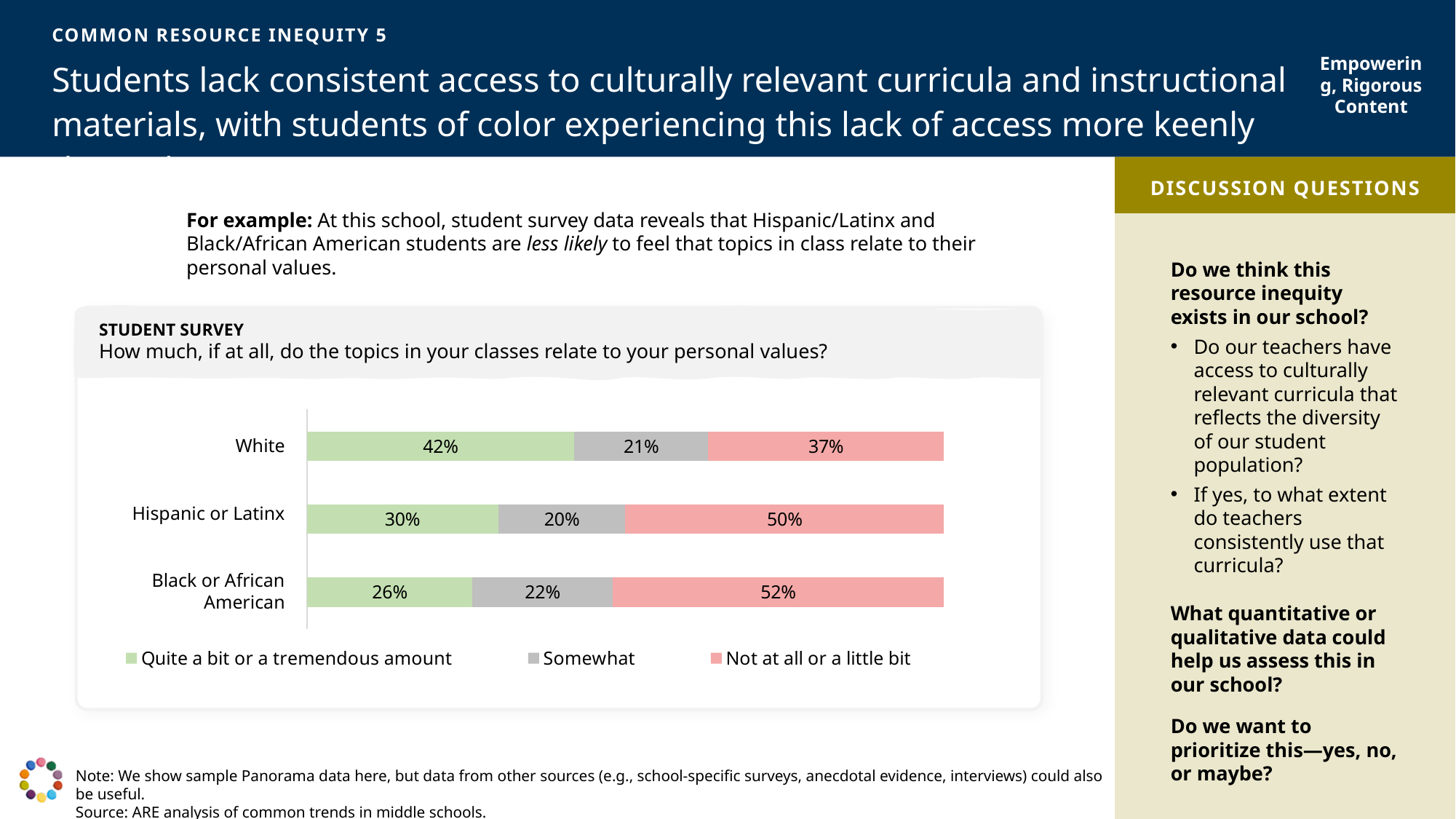
Which student group has the highest share answering "Not at all or a little bit"? Black or African American What percentage of White students answered "Quite a bit or a tremendous amount"? 42% How many response categories does the legend list? 3 What is the total of the three segments for the Hispanic or Latinx bar? 100% How many student groups are shown in the chart? 3 What survey question does the chart title ask? How much, if at all, do the topics in your classes relate to your personal values? What percentage of Hispanic or Latinx students answered "Not at all or a little bit"? 50% What type of chart is shown on the slide? Stacked bar chart What is the difference between the "Quite a bit or a tremendous amount" share for White students and for Hispanic or Latinx students? 12 percentage points What percentage of Black or African American students answered "Somewhat"? 22% Which is larger: the "Somewhat" share for White students or for Hispanic or Latinx students? White Which student group has the lowest share answering "Quite a bit or a tremendous amount"? Black or African American